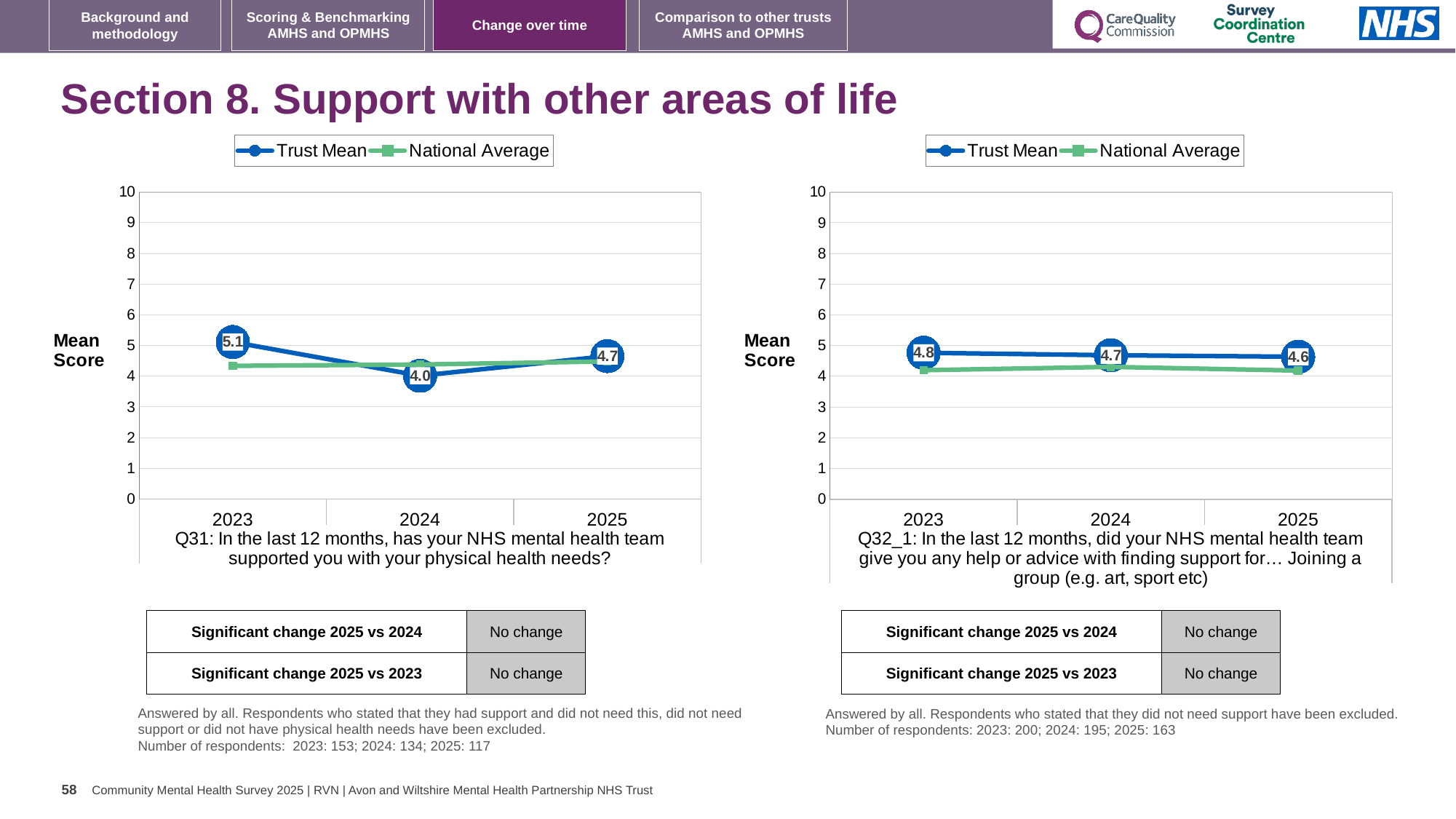
In the left chart (Q31), is the Trust Mean or the National Average higher in 2023? Trust Mean In the right chart (Q32_1), does the Trust Mean rise or fall from 2023 to 2025? fall In the right chart (Q32_1), which year has the highest Trust Mean score? 2023 In the left chart (Q31), which year has the highest Trust Mean score? 2023 In the left chart (Q31), what is the difference between the Trust Mean scores for 2023 and 2024? 1.1 In the right chart (Q32_1), what is the difference between the Trust Mean scores for 2023 and 2025? 0.2 How many series does the legend of the left chart (Q31) list? 2 In the right chart (Q32_1), is the National Average value for 2023 greater or less than 5? less In the left chart (Q31), what is the Trust Mean score for 2023? 5.1 In the right chart (Q32_1), what is the Trust Mean score for 2025? 4.6 In the left chart (Q31), which year has the lowest Trust Mean score? 2024 In the left chart (Q31), what is the Trust Mean score for 2024? 4.0